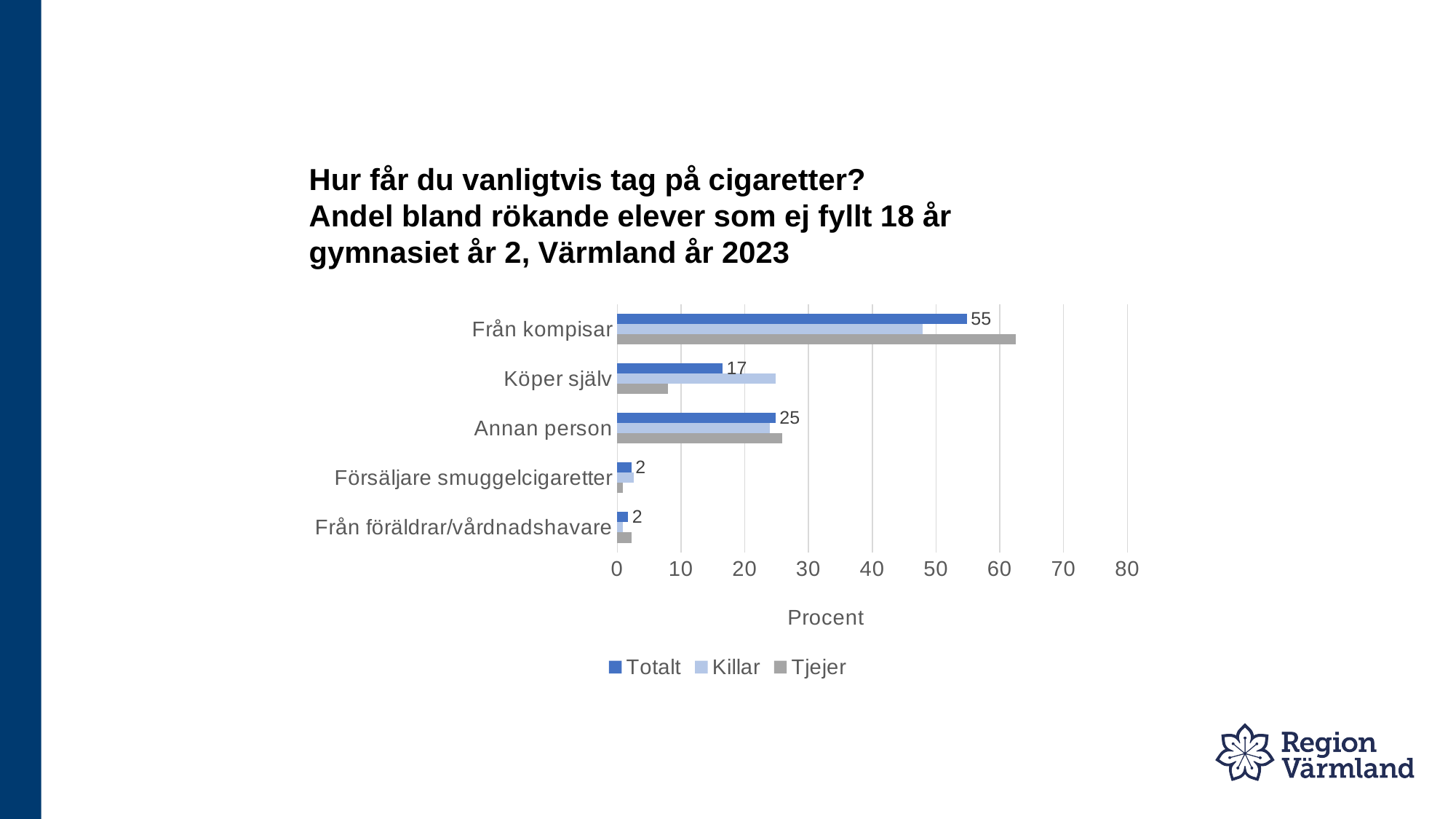
Which has the larger Totalt value, Köper själv or Annan person? Annan person How many series does the legend list? 3 What kind of chart is shown on the slide? bar chart What is the Totalt value for Köper själv? 17 Which category has the highest Totalt value? Från kompisar What is the Totalt value for Annan person? 25 What is the difference between the Totalt values for Från kompisar and Annan person? 30 What is the Totalt value for Från kompisar? 55 What is the Totalt value for Försäljare smuggelcigaretter? 2 How many categories are shown on the chart? 5 Is the Tjejer value for Köper själv greater or less than 10? less Is the Tjejer value for Från kompisar greater or less than 60? greater